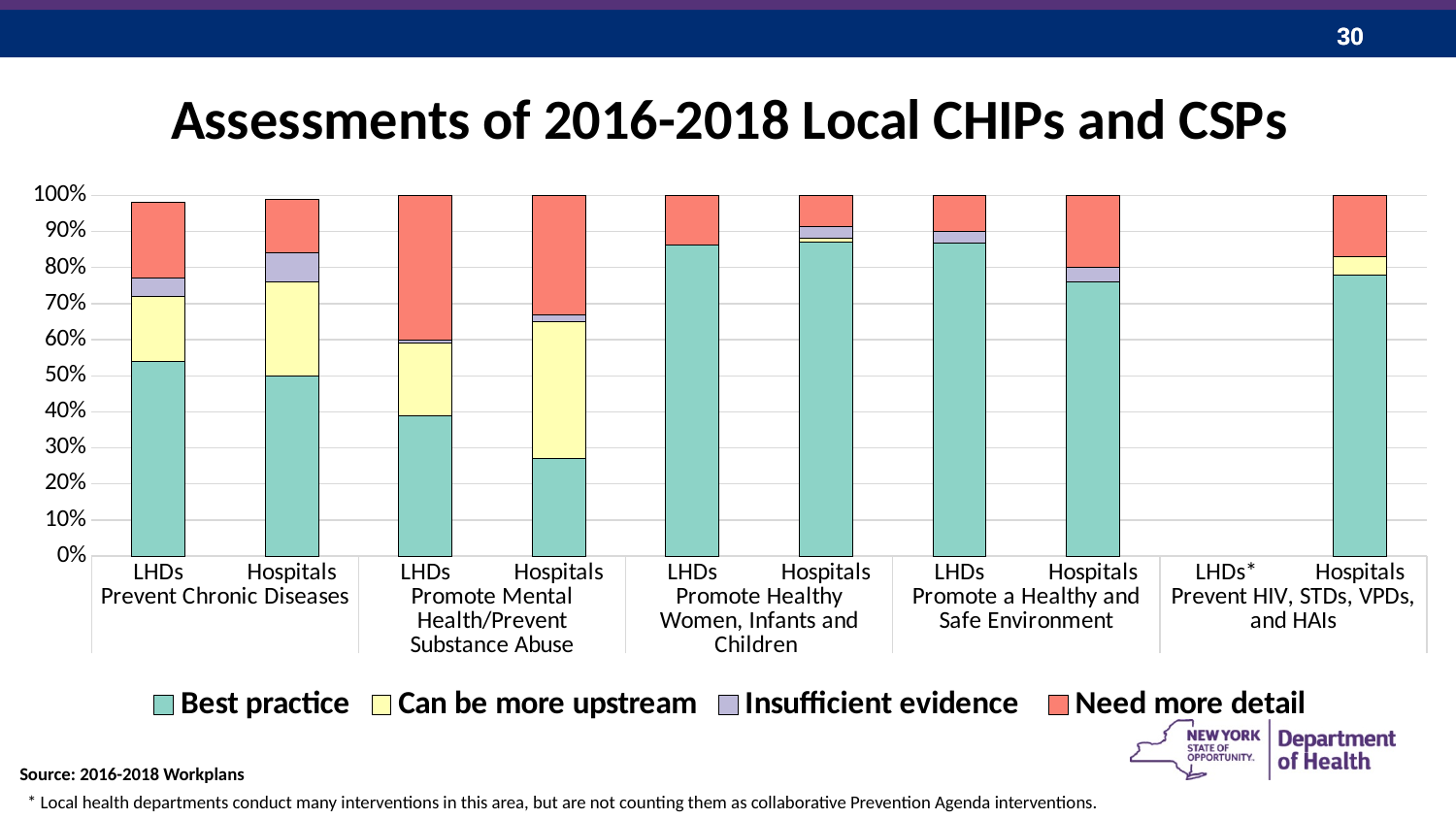
Which bar has the smallest Best practice share? Hospitals, Promote Mental Health/Prevent Substance Abuse What kind of chart is shown on the slide? Stacked bar chart Under Promote a Healthy and Safe Environment, which has the larger Best practice share, LHDs or Hospitals? LHDs Under Promote Mental Health/Prevent Substance Abuse, which has the larger Best practice share, LHDs or Hospitals? LHDs How many priority areas are listed along the x axis? 5 How many series does the legend list? 4 Is the Best practice share for LHDs under Prevent Chronic Diseases greater or less than 50%? greater Is the Best practice share for LHDs under Promote Mental Health/Prevent Substance Abuse greater or less than 50%? less Is the Best practice share for LHDs under Promote Healthy Women, Infants and Children greater or less than 80%? greater Which bar has the largest Can be more upstream segment? Hospitals, Promote Mental Health/Prevent Substance Abuse Which priority area has no bar plotted for LHDs? Prevent HIV, STDs, VPDs, and HAIs